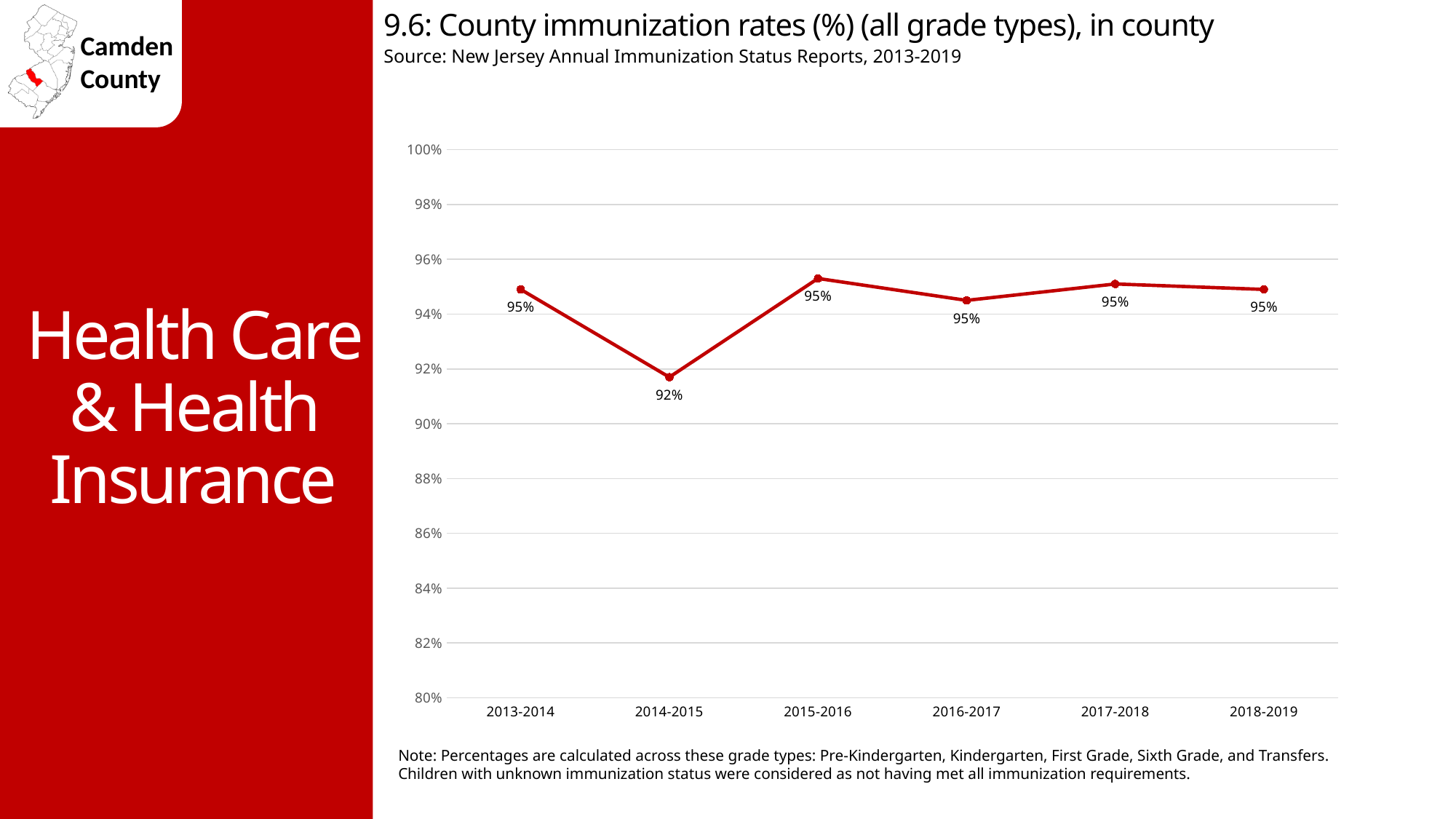
What is the difference between the immunization rates for 2013-2014 and 2014-2015? 3 percentage points Is the value for 2015-2016 greater or less than 94%? greater What is the county immunization rate for 2014-2015? 92% Is the value for 2014-2015 greater or less than 94%? less What is the county immunization rate for 2018-2019? 95% What is the source cited for the chart? New Jersey Annual Immunization Status Reports, 2013-2019 Which has a higher immunization rate, 2014-2015 or 2015-2016? 2015-2016 What kind of chart is shown on the slide? Line chart Does the immunization rate rise or fall from 2013-2014 to 2014-2015? Fall How many school years are plotted on the chart? 6 Which school year has the lowest immunization rate? 2014-2015 What is the county immunization rate for 2013-2014? 95%